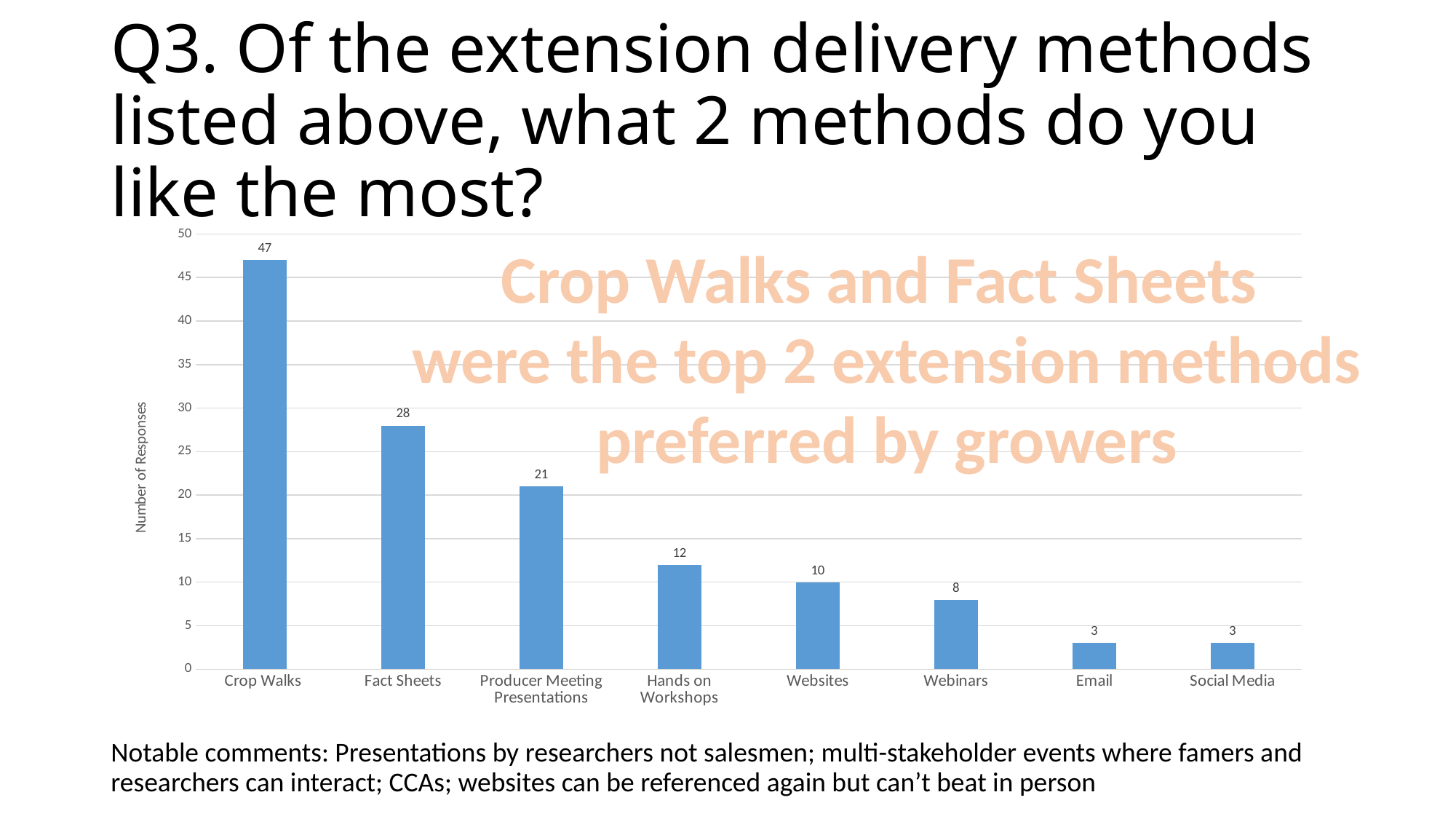
How many responses did Hands on Workshops receive? 12 How many extension delivery methods are shown on the x axis? 8 Which extension delivery method has the highest number of responses? Crop Walks What is the value for Fact Sheets? 28 Is the value for Producer Meeting Presentations greater or less than 20? greater What is the difference in responses between Crop Walks and Fact Sheets? 19 What type of chart is shown on the slide? Bar chart What is the label of the vertical axis? Number of Responses Which categories have the lowest number of responses? Email and Social Media What is the difference between Producer Meeting Presentations and Webinars? 13 Which has more responses, Websites or Webinars? Websites How many responses did Crop Walks receive? 47